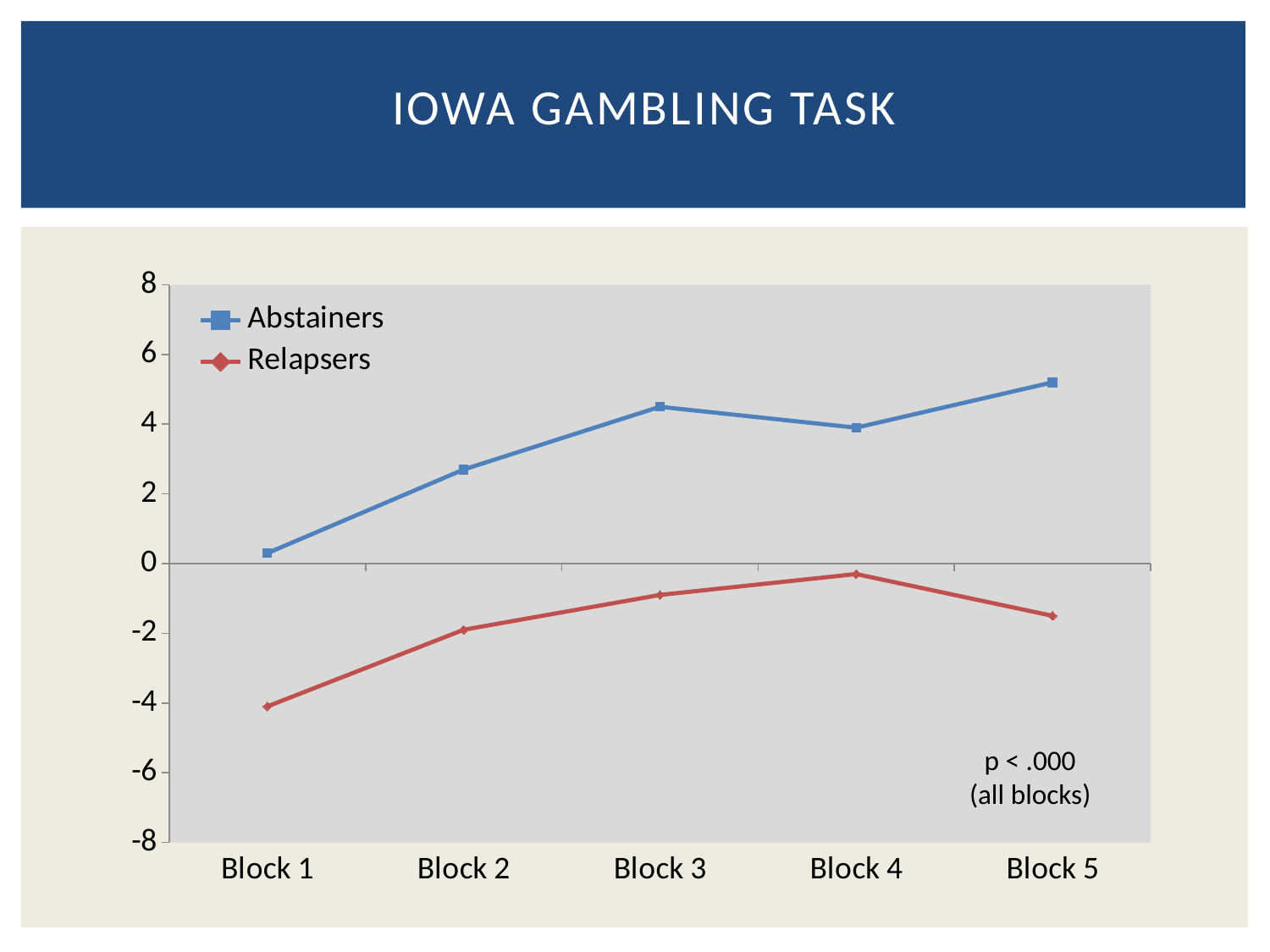
Is the value for Relapsers at Block 3 greater or less than 0? less Is the value for Abstainers at Block 2 greater or less than 2? greater In which block does the Relapsers series have its lowest value? Block 1 How many series does the legend list? 2 In which block does the Relapsers series reach its highest value? Block 4 At Block 3, which series has the larger value, Abstainers or Relapsers? Abstainers Is the value for Abstainers at Block 3 greater or less than 4? greater How many blocks are shown along the x axis? 5 In which block does the Abstainers series reach its highest value? Block 5 In which block does the Abstainers series have its lowest value? Block 1 What kind of chart is shown on the slide? line chart Do the Relapsers values rise or fall from Block 1 to Block 4? rise